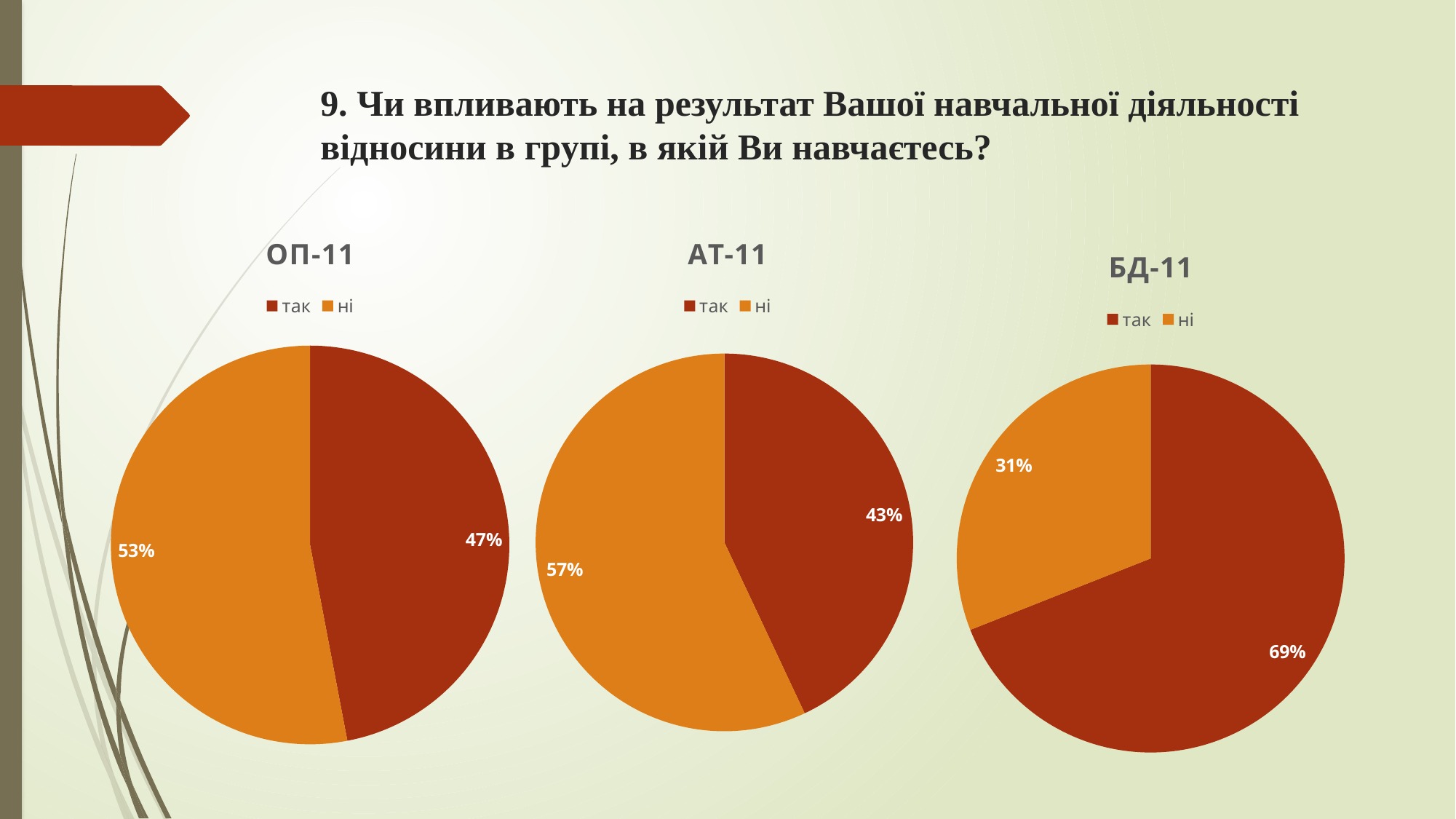
How many pie charts are on the slide? 3 What type of chart is used for ОП-11? Pie chart In the АТ-11 chart, which slice is the largest? ні How many entries does the legend of the АТ-11 chart list? 2 In the АТ-11 chart, what percentage is shown for "ні"? 57% In the БД-11 chart, which slice is larger, "так" or "ні"? так In the БД-11 chart, what is the difference between the "так" and "ні" shares? 38% In the БД-11 chart, what percentage is shown for "так"? 69% In the БД-11 chart, what percentage is shown for "ні"? 31% In the АТ-11 chart, what percentage is shown for "так"? 43% In the ОП-11 chart, what percentage is shown for "так"? 47% In the ОП-11 chart, what percentage is shown for "ні"? 53%